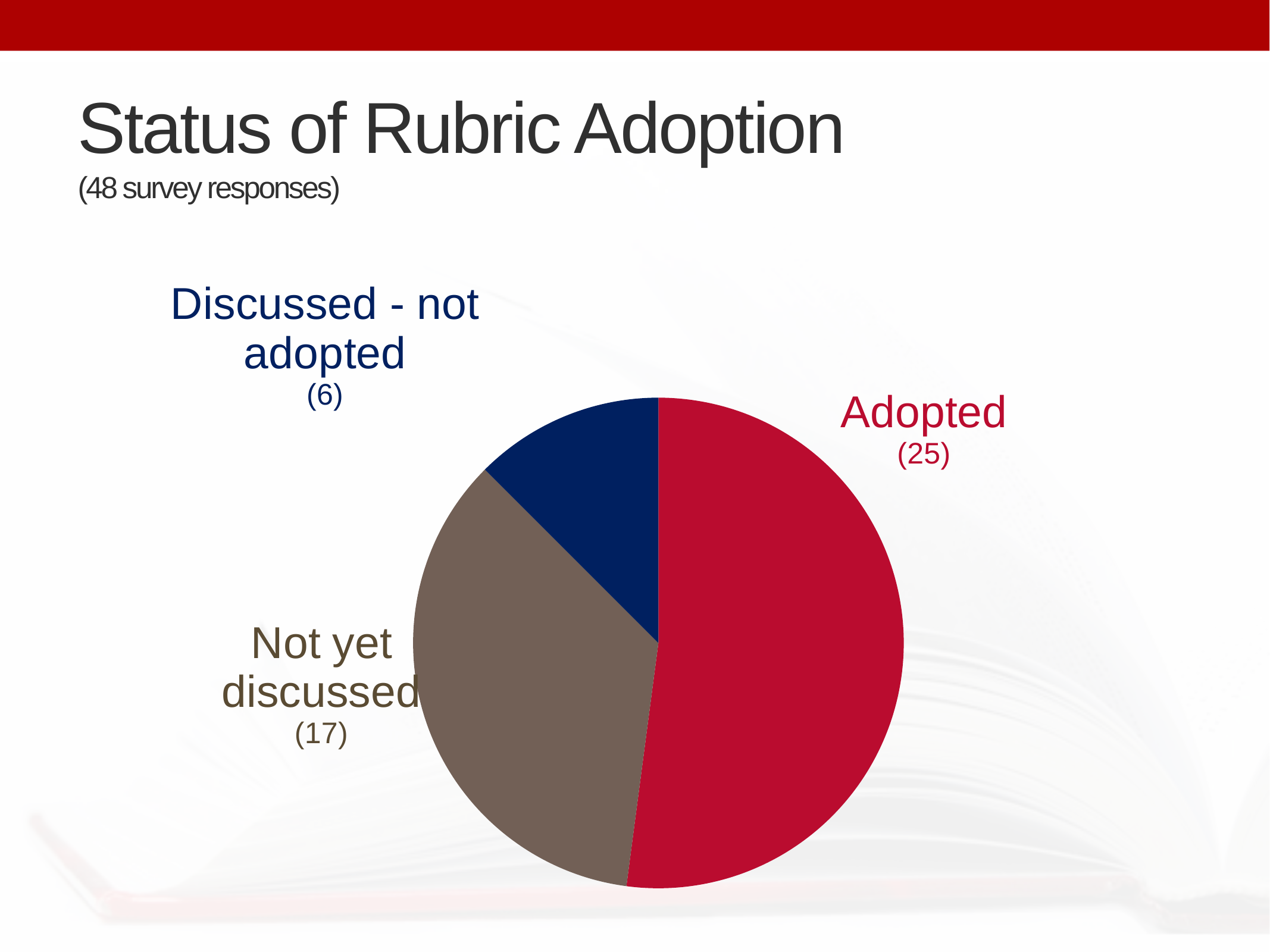
What kind of chart is shown on the slide? pie chart Which category has the largest slice of the pie? Adopted How many responses are in the Discussed - not adopted category? 6 How many responses are in the Adopted category? 25 What is the total number of survey responses shown in the pie chart? 48 Which is larger, Not yet discussed or Discussed - not adopted? Not yet discussed What is the title of the slide containing the pie chart? Status of Rubric Adoption What is the difference between the Adopted and Not yet discussed counts? 8 How many categories does the pie chart have? 3 What colour is the Adopted slice of the pie? red Which category has the smallest slice of the pie? Discussed - not adopted How many responses are in the Not yet discussed category? 17